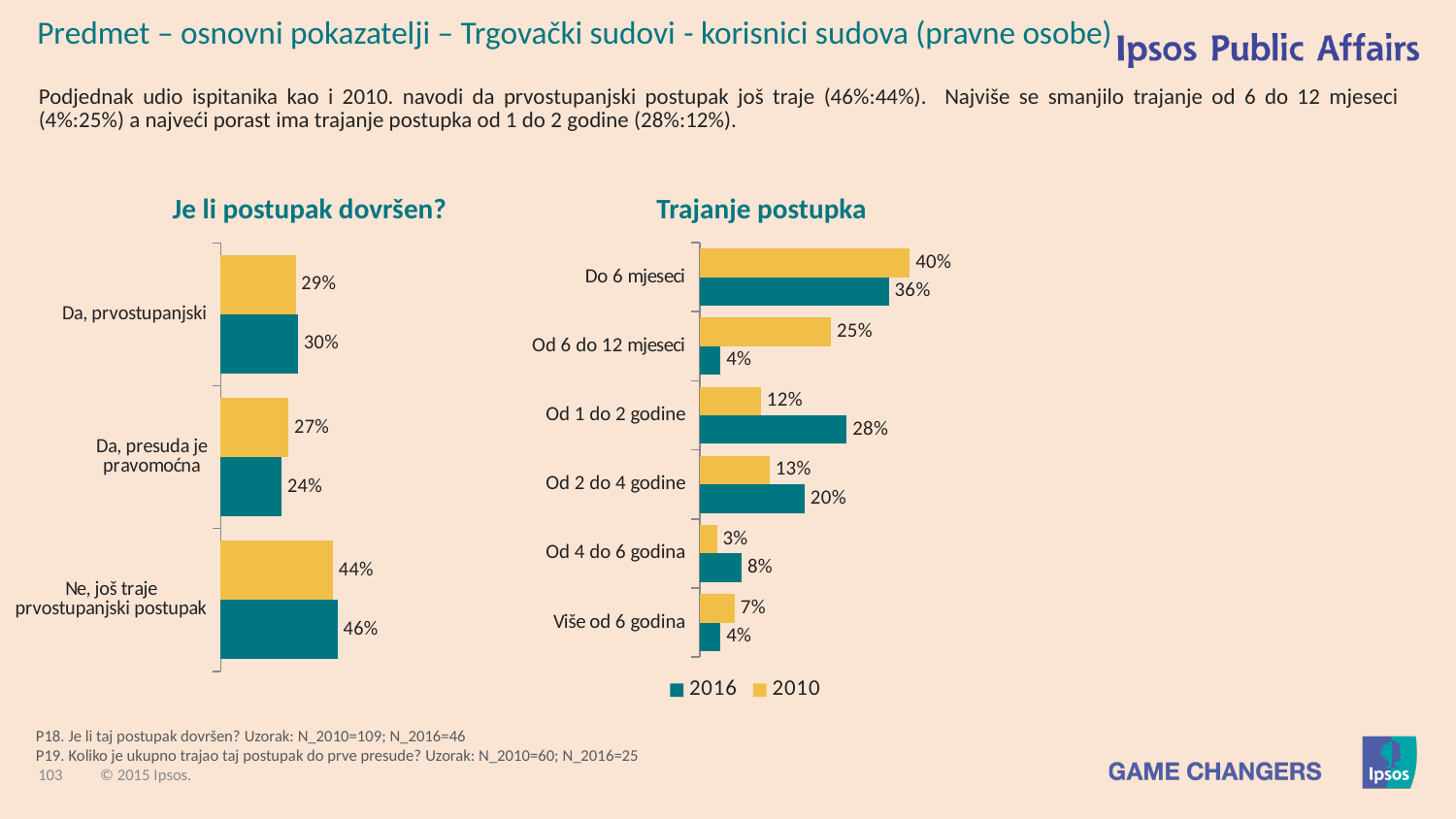
In the 'Trajanje postupka' chart, which category has the highest 2016 value? Do 6 mjeseci In the 'Trajanje postupka' chart, what is the difference between the 2010 and 2016 values for 'Od 6 do 12 mjeseci'? 21 percentage points How many series does the legend list? 2 In the 'Trajanje postupka' chart, what is the 2016 value for 'Od 1 do 2 godine'? 28% In the 'Je li postupak dovršen?' chart, what is the 2016 value for 'Ne, još traje prvostupanjski postupak'? 46% How many categories does the 'Trajanje postupka' chart show? 6 In the 'Je li postupak dovršen?' chart, what is the 2010 value for 'Da, presuda je pravomoćna'? 27% In the 'Trajanje postupka' chart, what is the 2010 value for 'Od 6 do 12 mjeseci'? 25% In the 'Trajanje postupka' chart, which is larger for 'Više od 6 godina': the 2016 value or the 2010 value? 2010 In the 'Je li postupak dovršen?' chart, which category has the highest 2016 value? Ne, još traje prvostupanjski postupak In the 'Je li postupak dovršen?' chart, what is the difference between the 2016 and 2010 values for 'Da, presuda je pravomoćna'? 3 percentage points In the 'Trajanje postupka' chart, which category has the lowest 2010 value? Od 4 do 6 godina